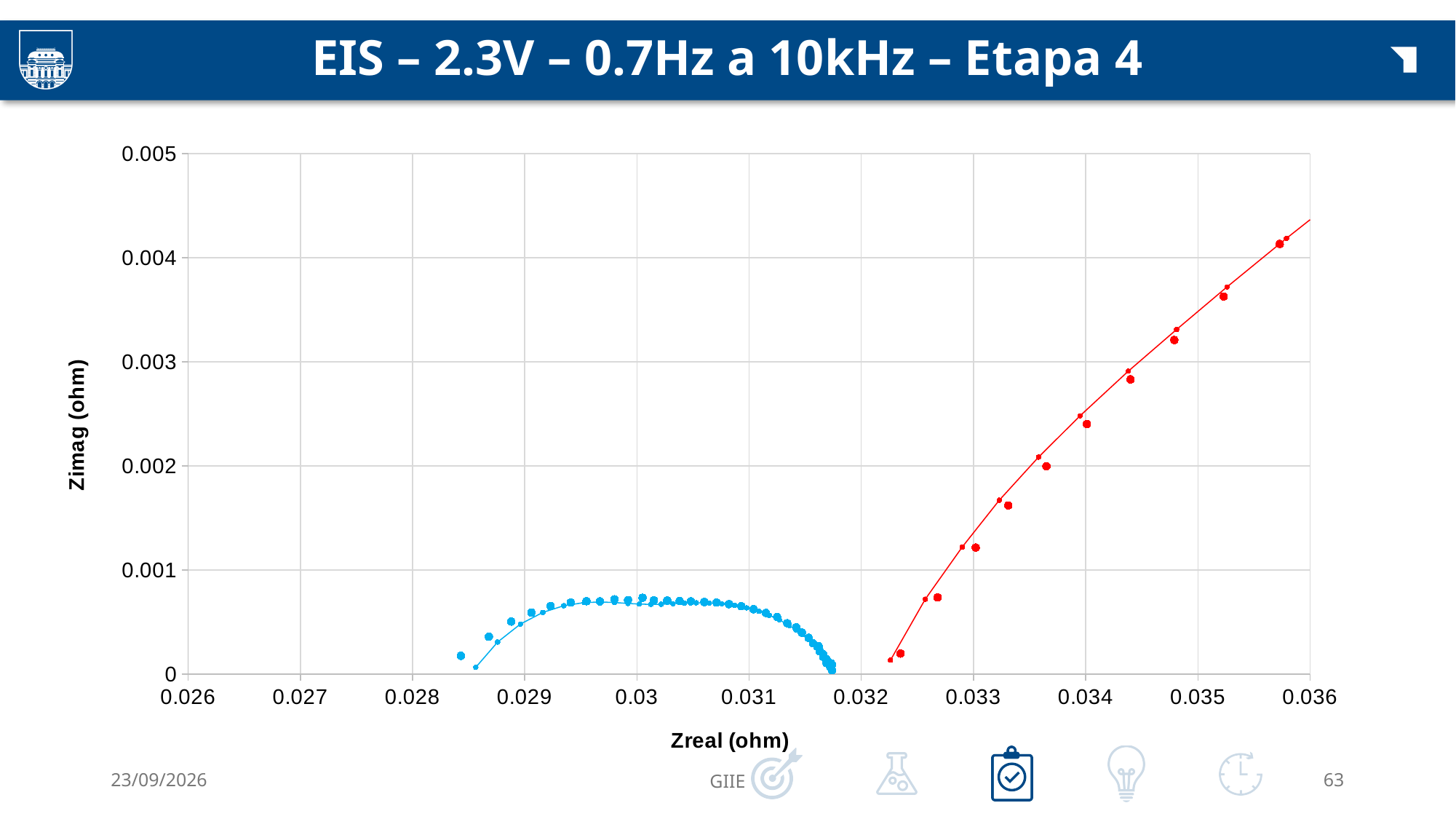
Is the Zreal value at which the blue series begins greater or less than 0.029? less Is the highest Zimag value reached by the blue series greater or less than 0.001? less Is the Zreal value at which the red series begins greater or less than 0.032? greater What is the label of the horizontal axis? Zreal (ohm) What is the maximum value shown on the vertical axis? 0.005 What is the title of the chart on the slide? EIS – 2.3V – 0.7Hz a 10kHz – Etapa 4 Which series reaches the higher Zimag value, the blue one or the red one? Red Does the red series rise or fall as Zreal increases? Rises What kind of chart is shown on the slide? Scatter chart